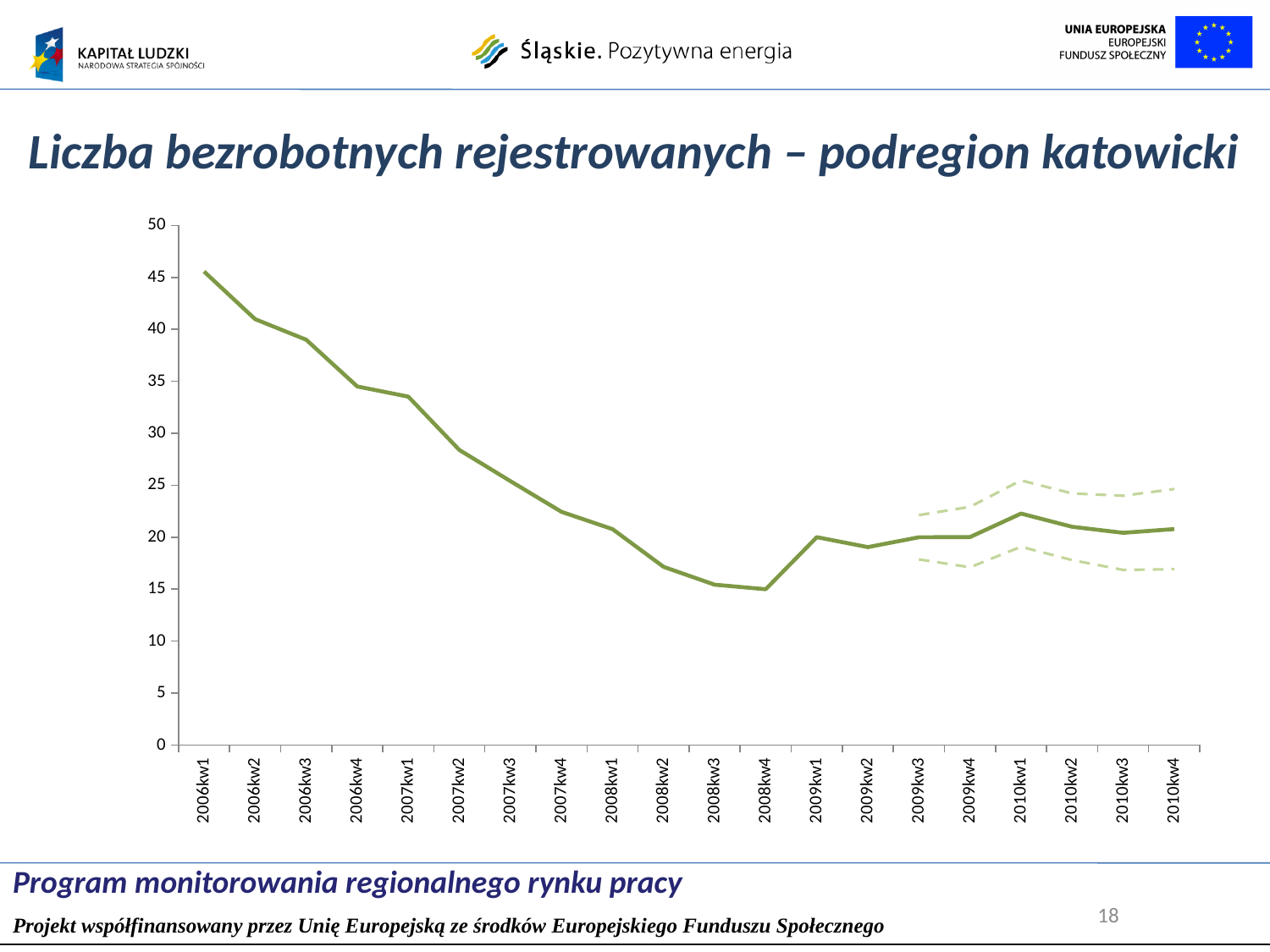
Is the value for 2008kw4 greater or less than 20? less Is the value for 2006kw1 greater or less than 40? greater Which quarter has the lowest value on the solid line? 2008kw4 Which is larger, the value for 2006kw2 or the value for 2007kw2? 2006kw2 Do the values on the solid line rise or fall from 2006kw1 to 2008kw4? fall How many quarters are plotted along the x axis? 20 Is the value for 2007kw1 greater or less than 30? greater From which quarter do the dashed lines above and below the solid line begin? 2009kw3 What is the title of the slide containing the chart? Liczba bezrobotnych rejestrowanych – podregion katowicki Which quarter has the highest value on the solid line? 2006kw1 What kind of chart is shown on the slide? line chart